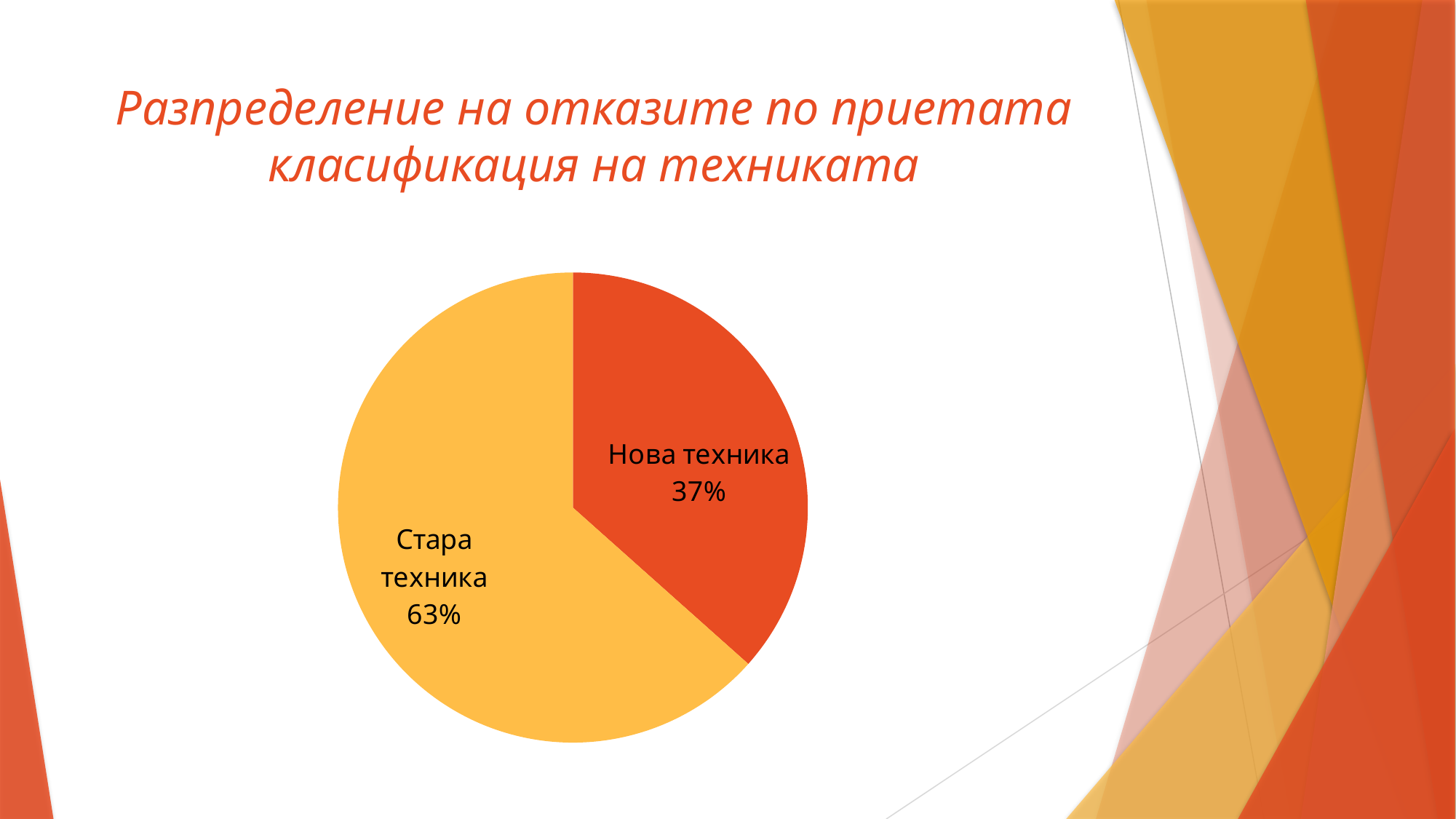
Is the share for Стара техника greater or less than 50%? greater Which is larger, the slice for Стара техника or the slice for Нова техника? Стара техника What share of the pie does Стара техника have? 63% What kind of chart is shown on the slide? pie chart What is the title of the slide containing the pie chart? Разпределение на отказите по приетата класификация на техниката What share of the pie does Нова техника have? 37% What is the difference in percentage points between Стара техника and Нова техника? 26 Is the share for Нова техника greater or less than 50%? less Which category has the largest slice of the pie? Стара техника Which category has the smallest slice of the pie? Нова техника How many slices does the pie chart have? 2 What colour is the slice for Нова техника? red-orange